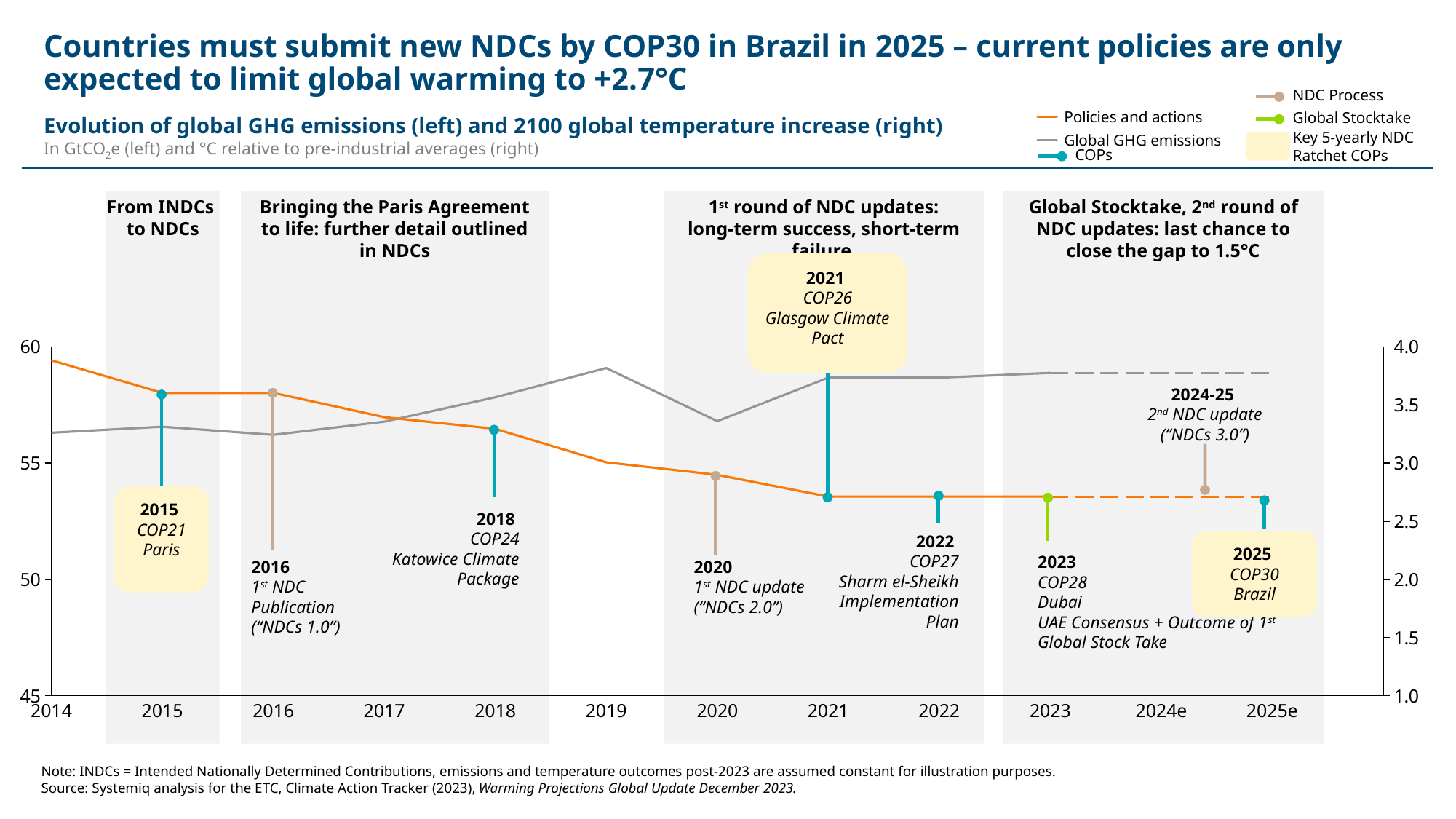
According to the chart annotations, in which year is COP30 in Brazil held? 2025 Is the value of the Global GHG emissions line in 2019 greater or less than 55 on the left axis? greater Is the value of the Policies and actions line in 2014 greater or less than 3.5 on the right axis? greater Is the value of the Global GHG emissions line in 2021 greater or less than 60 on the left axis? less How many year labels are shown on the x axis? 12 Does the Policies and actions line rise or fall from 2014 to 2023? fall How many entries does the chart legend list? 6 In which year is the Policies and actions line at its highest? 2014 Does the Global GHG emissions line rise or fall overall from 2014 to 2025e? rise What kind of chart is shown on the slide? line chart Which year has the higher Global GHG emissions value, 2016 or 2019? 2019